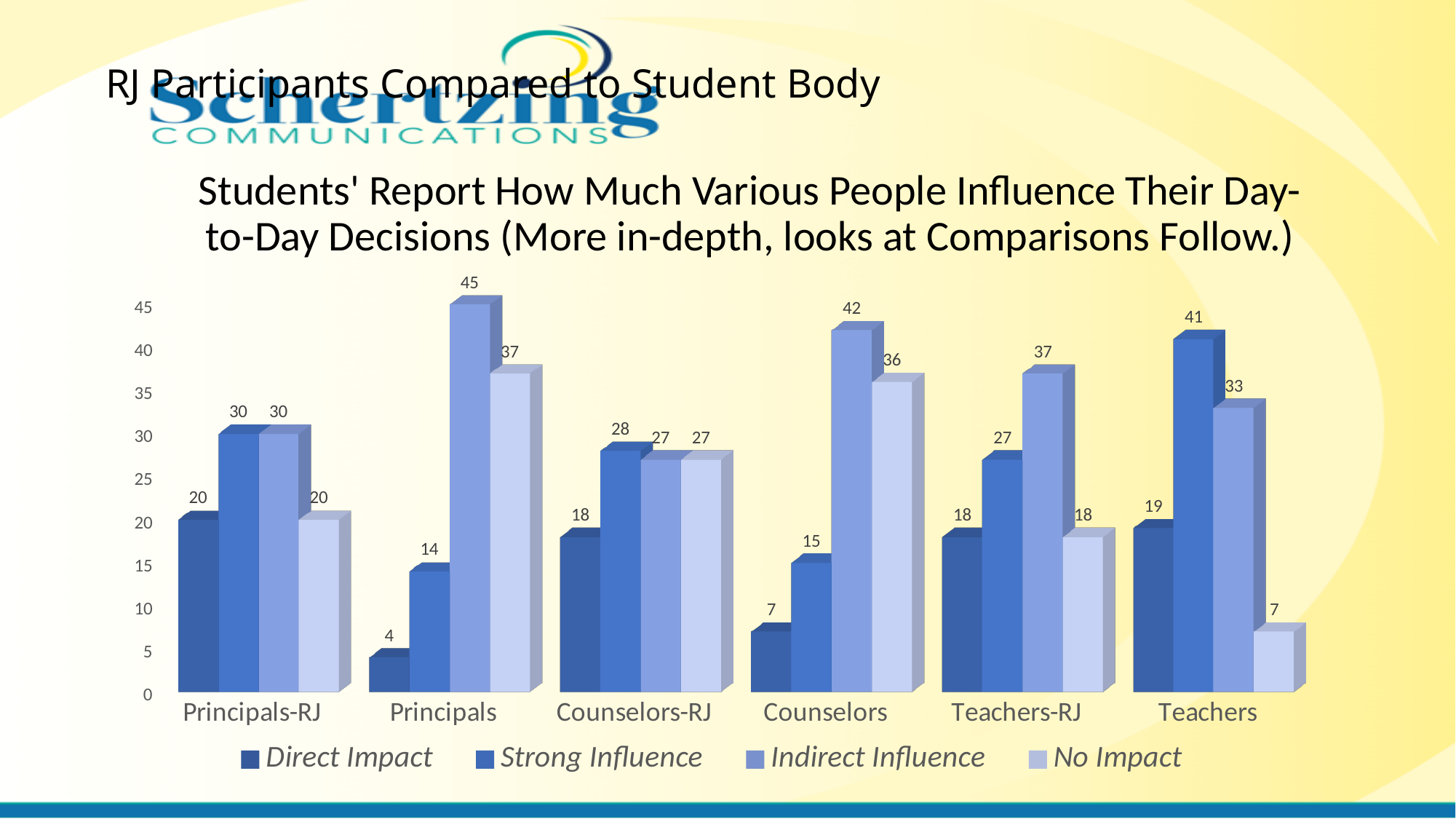
What is the Indirect Influence value for Principals? 45 What kind of chart is shown on the slide? Bar chart What is the No Impact value for Teachers? 7 How many series does the legend list? 4 What is the Direct Impact value for Principals-RJ? 20 Which is larger: the Strong Influence value for Teachers or the Strong Influence value for Teachers-RJ? Teachers What is the Strong Influence value for Counselors? 15 What is the difference between the No Impact values for Principals and Teachers? 30 Which category has the highest Indirect Influence value? Principals What is the last entry in the chart's legend? No Impact Which category has the lowest Direct Impact value? Principals How many categories are shown on the x axis? 6